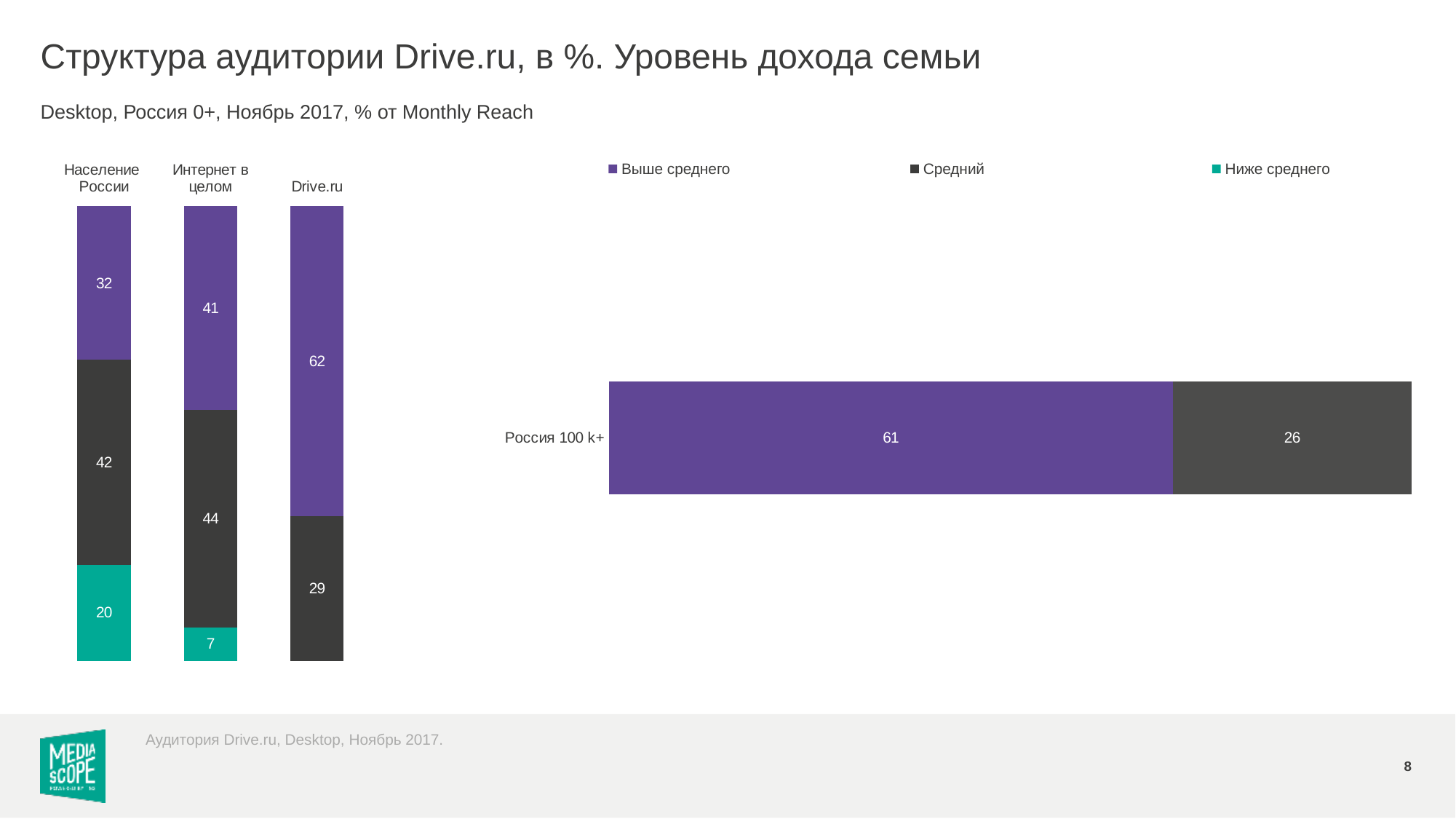
In the right horizontal bar chart, what is the total of the "Россия 100 k+" bar? 87 In the left stacked bar chart, which is larger: the "Средний" value for "Население России" or for Drive.ru? Население России How many series does the legend list? 3 What kind of chart is the chart on the right of the slide? Stacked bar chart In the right horizontal bar chart, what is the value for "Выше среднего" for "Россия 100 k+"? 61 In the left stacked bar chart, how many categories are shown on the x axis? 3 In the left stacked bar chart, what is the value for "Средний" for "Интернет в целом"? 44 In the left stacked bar chart, what is the difference between the "Выше среднего" values for Drive.ru and "Население России"? 30 In the left stacked bar chart, what is the value for "Ниже среднего" for "Население России"? 20 In the left stacked bar chart, what is the value for "Выше среднего" for Drive.ru? 62 In the left stacked bar chart, which category has the highest value for "Выше среднего"? Drive.ru